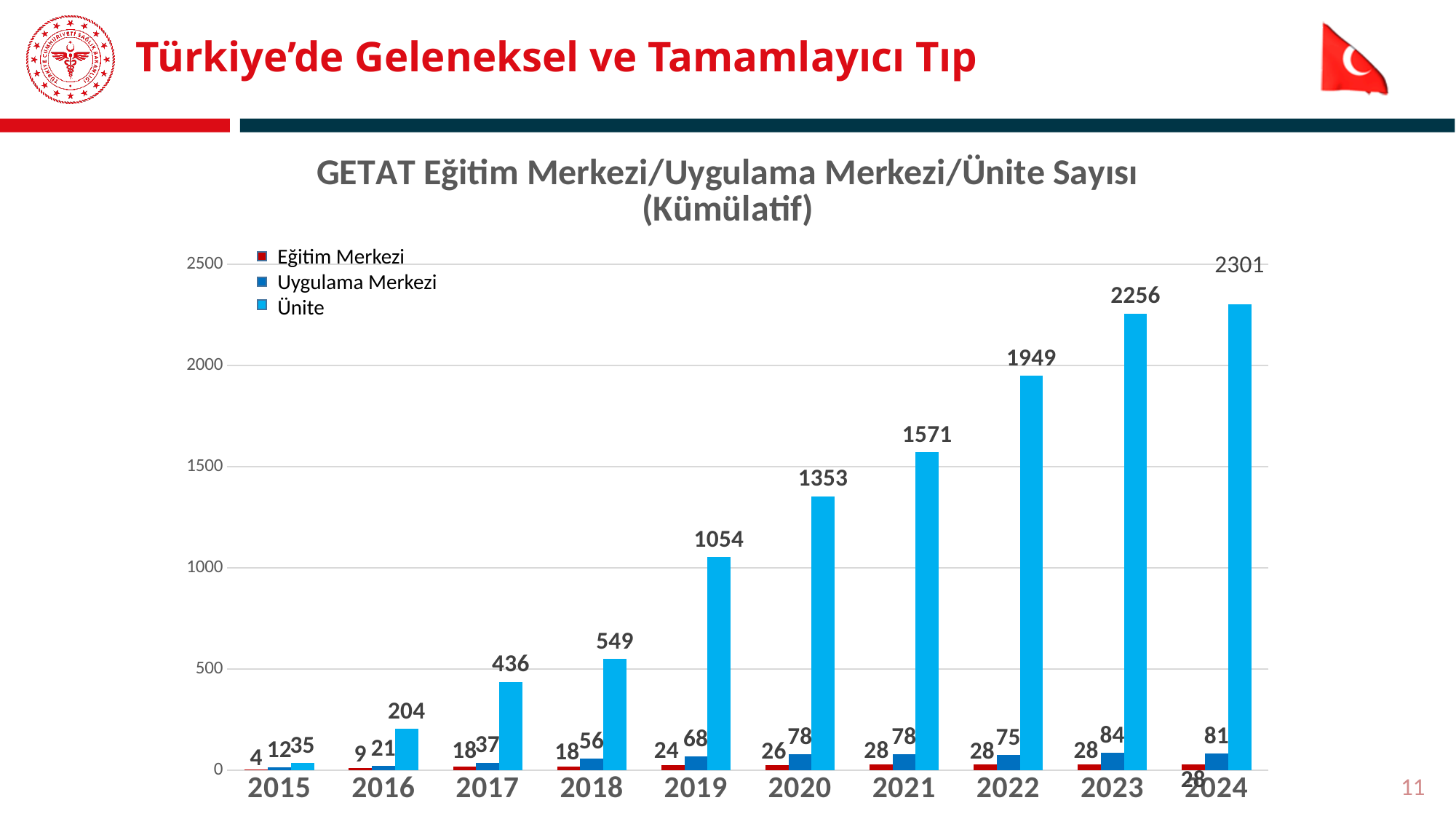
How many series does the legend list? 3 Which is larger, the Ünite value for 2018 or for 2019? 2019 What kind of chart is this? bar chart What is the Eğitim Merkezi value for 2016? 9 Do the Ünite values rise or fall from 2015 to 2024? rise What is the Uygulama Merkezi value for 2019? 68 Is the Ünite value for 2021 greater or less than 1500? greater Which year has the lowest Ünite value? 2015 Which year has the highest Uygulama Merkezi value? 2023 What is the difference between the Ünite values for 2023 and 2022? 307 What is the Ünite value for 2024? 2301 How many years are shown on the x axis? 10